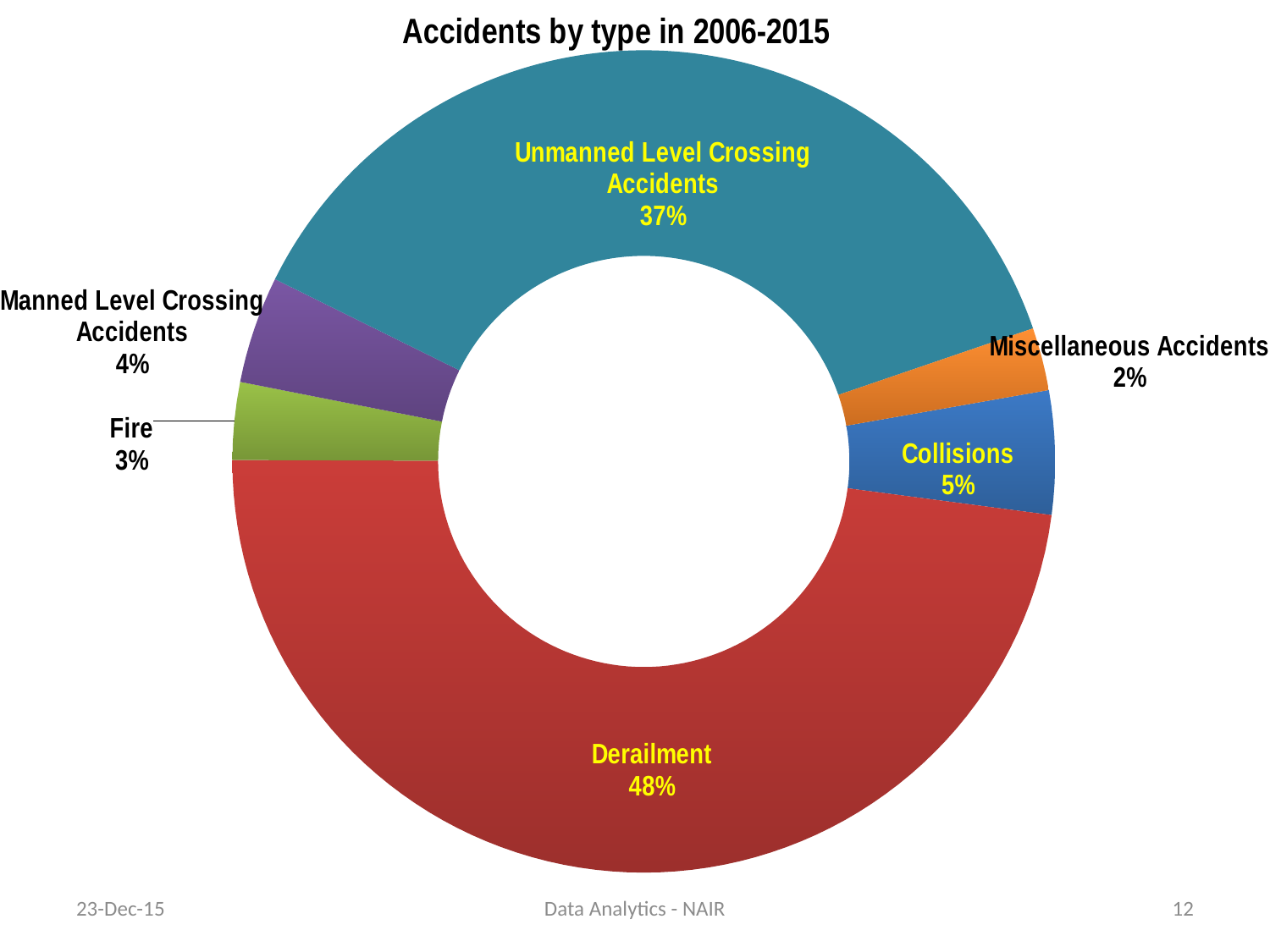
How many accident types are shown in the chart? 6 What share of accidents is Unmanned Level Crossing Accidents? 37% What percentage is shown for Fire? 3% What percentage is shown for Manned Level Crossing Accidents? 4% What share of accidents is Derailment? 48% What percentage is shown for Collisions? 5% What kind of chart is shown on the slide? Pie chart (doughnut) What is the difference in percentage points between Derailment and Unmanned Level Crossing Accidents? 11 Which accident type has the largest share? Derailment Which is larger, the share for Collisions or the share for Fire? Collisions Which accident type has the smallest share? Miscellaneous Accidents What is the title of the chart? Accidents by type in 2006-2015